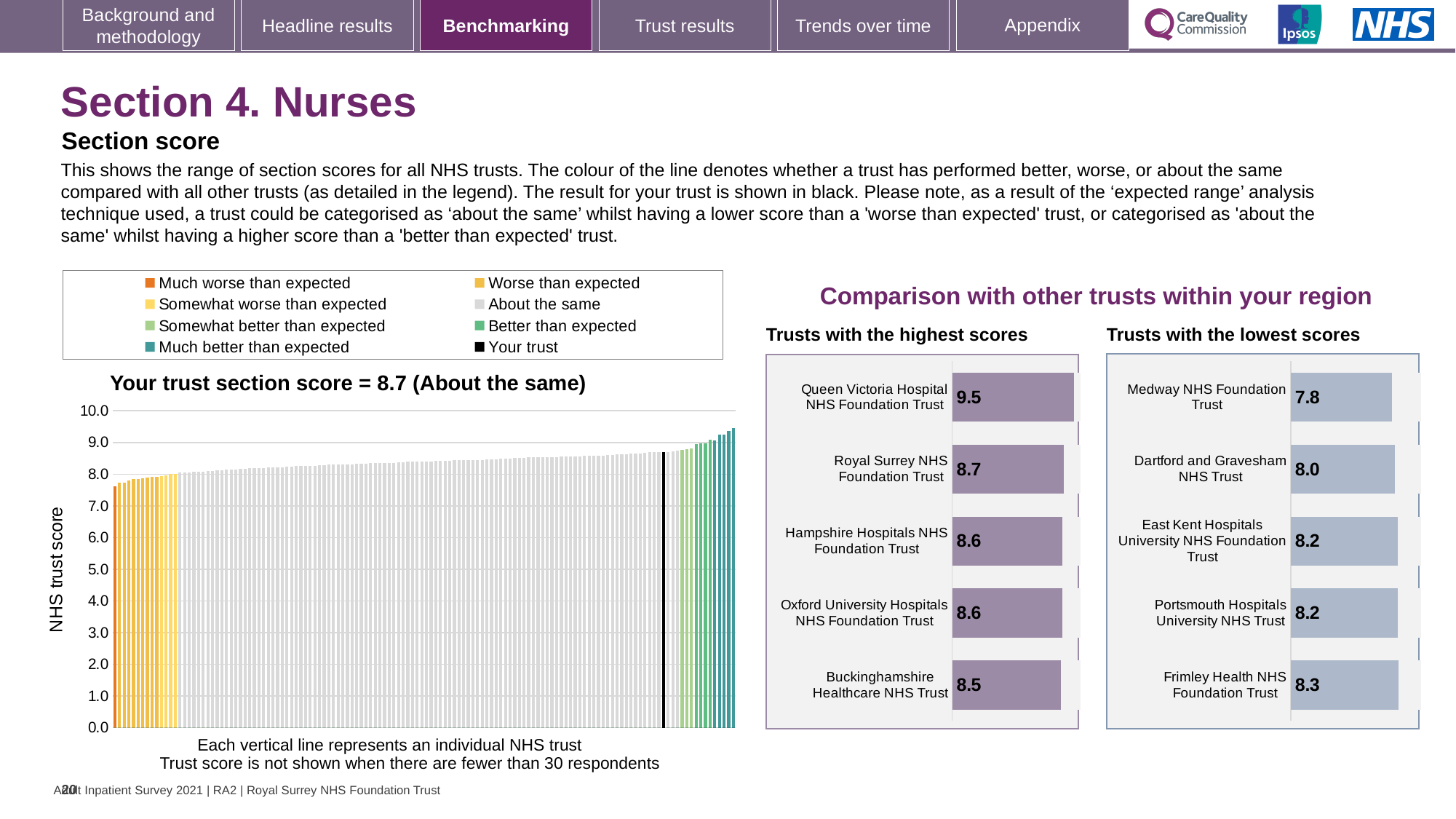
In the 'Your trust section score' chart, what is the section score for your trust? 8.7 In the 'Your trust section score' chart, what kind of chart is shown? bar chart In the 'Your trust section score' chart, how many entries does the legend list? 8 In the 'Your trust section score' chart, do the values rise or fall from left to right along the x axis? rise In the 'Trusts with the highest scores' chart, what is the score for Queen Victoria Hospital NHS Foundation Trust? 9.5 In the 'Trusts with the highest scores' chart, what is the difference between the scores of Queen Victoria Hospital NHS Foundation Trust and Buckinghamshire Healthcare NHS Trust? 1.0 In the 'Your trust section score' chart, is the value of the tallest bar greater or less than 9.0? greater In the 'Trusts with the highest scores' chart, which trust has the highest score? Queen Victoria Hospital NHS Foundation Trust In the 'Trusts with the lowest scores' chart, how many trusts are shown? 5 In the 'Trusts with the lowest scores' chart, which trust has the lowest score? Medway NHS Foundation Trust In the 'Trusts with the lowest scores' chart, which has the larger score: Dartford and Gravesham NHS Trust or Frimley Health NHS Foundation Trust? Frimley Health NHS Foundation Trust In the 'Your trust section score' chart, what is the label on the vertical axis? NHS trust score